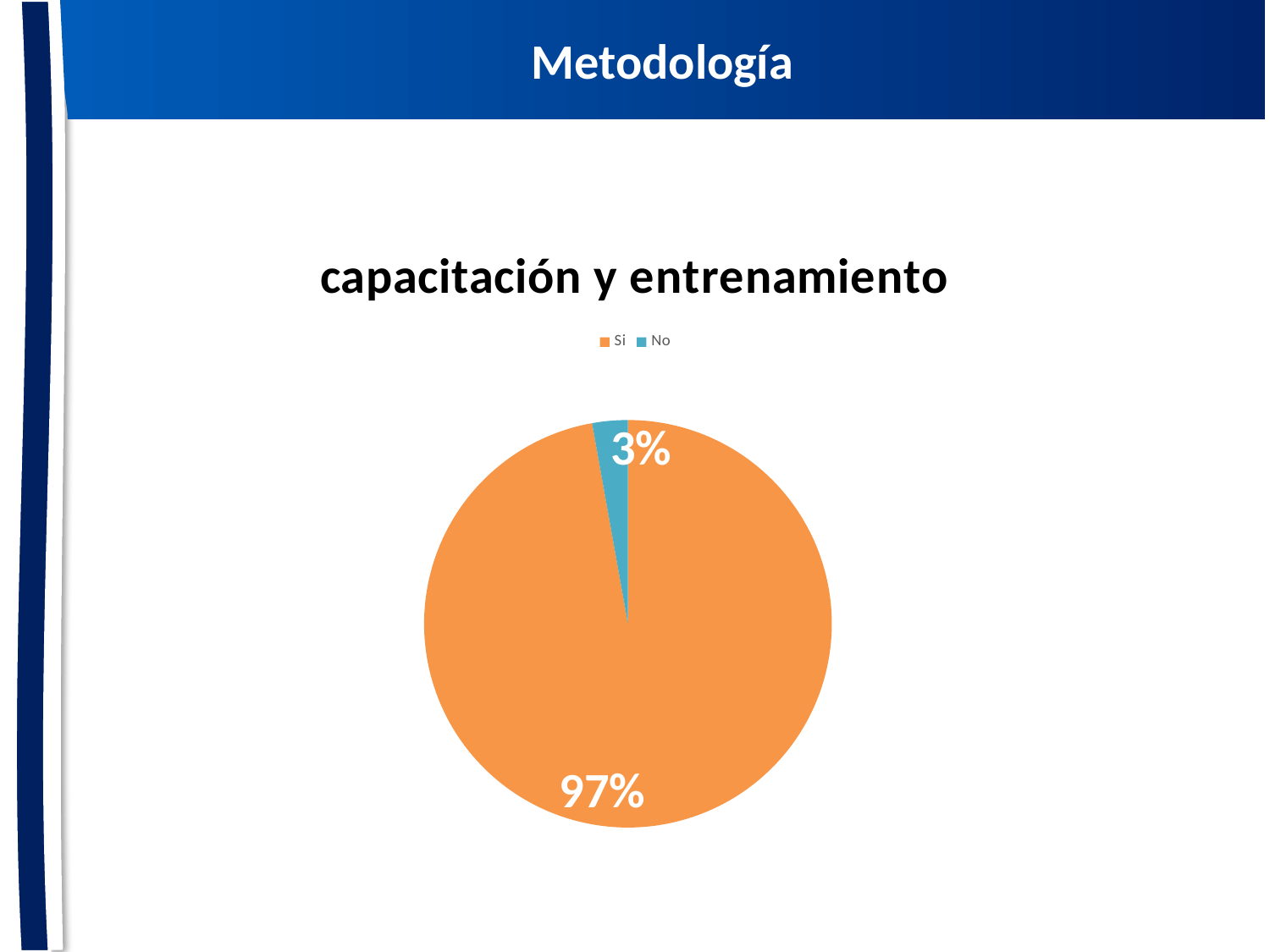
How many entries does the legend list? 2 What type of chart is shown on the slide? pie chart How many categories does the pie chart show? 2 Which category has the smallest share of the pie? No Which slice is larger, 'Si' or 'No'? Si Which category has the largest share of the pie? Si What percentage of the pie does the 'No' slice represent? 3% What colour is the 'Si' slice? orange What is the title of the chart? capacitación y entrenamiento What percentage of the pie does the 'Si' slice represent? 97% What is the share of the pie taken by the 'No' slice? 3% What is the difference in percentage points between the 'Si' and 'No' slices? 94